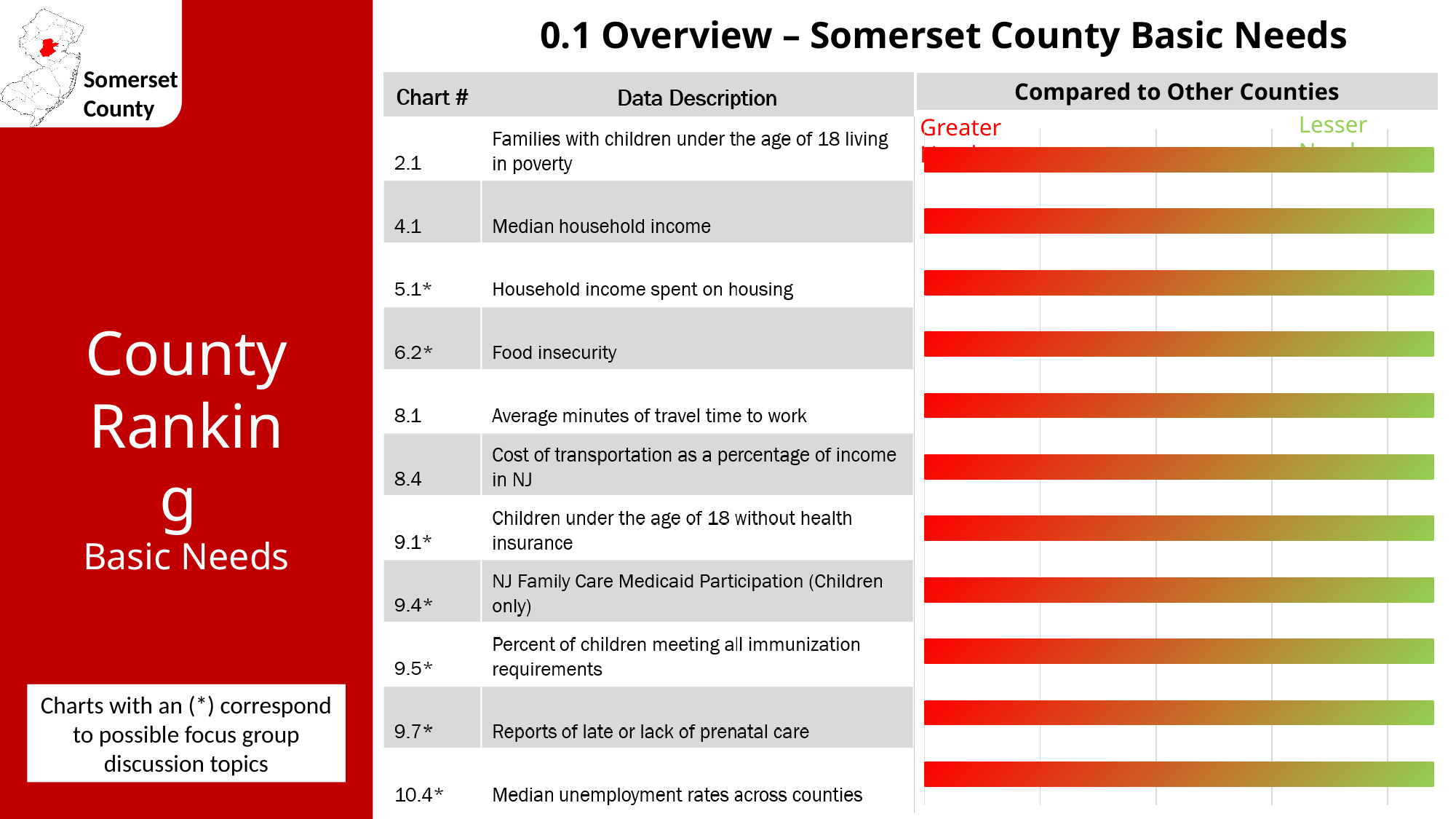
In the "Compared to Other Counties" chart, which colour marks the "Greater Need" end of the bars? red Which chart number is listed for the category "Median household income" in the "Compared to Other Counties" chart? 4.1 How many of the chart numbers listed as categories in the "Compared to Other Counties" chart are marked with an asterisk (*)? 7 Which chart number is listed for the category "Food insecurity" in the "Compared to Other Counties" chart? 6.2* What is the title shown above the bar chart on the right of the slide? Compared to Other Counties How many bars are plotted in the "Compared to Other Counties" chart? 11 What kind of chart is shown under the heading "Compared to Other Counties"? bar chart